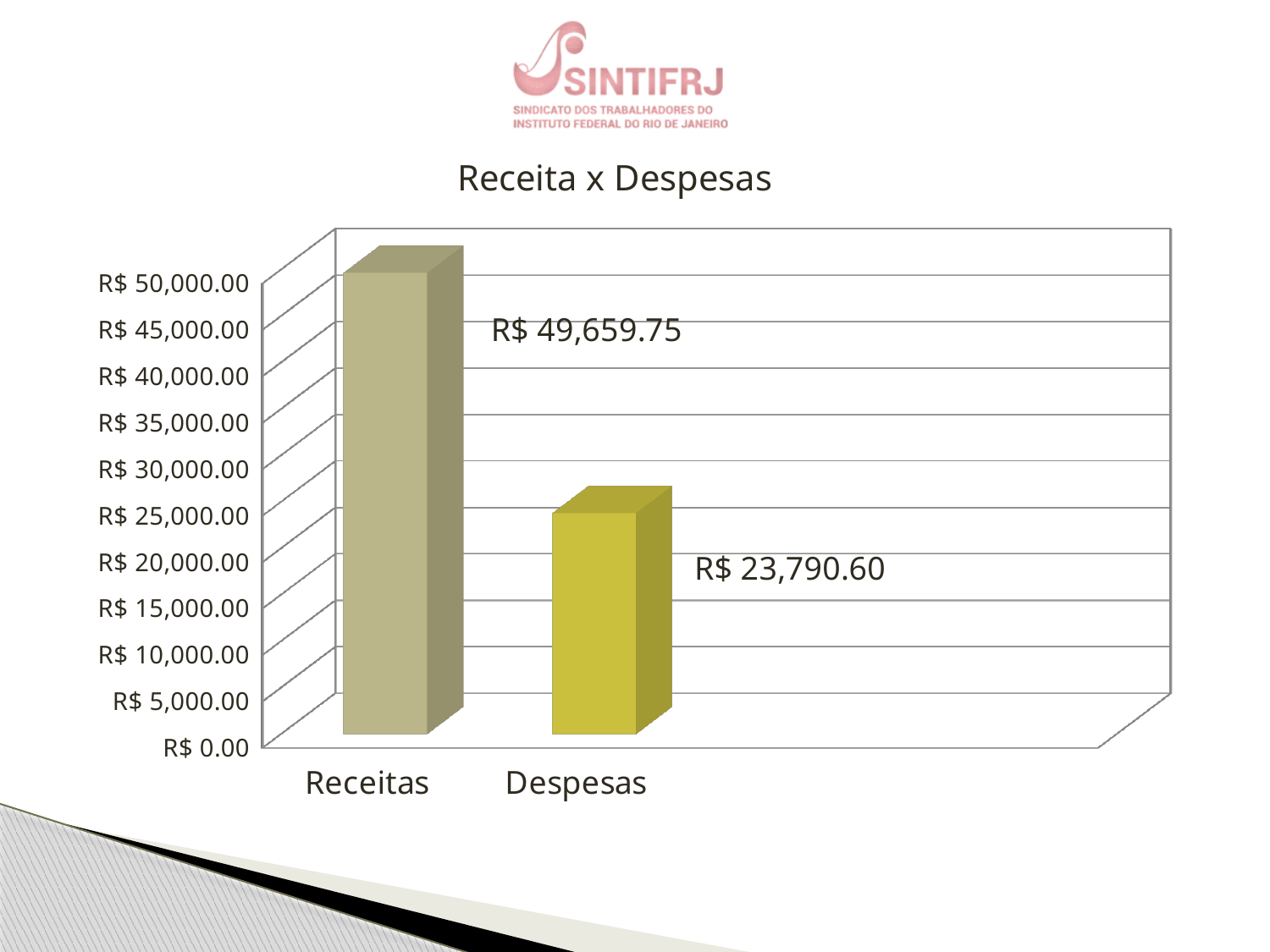
Is the value for Receitas greater or less than R$ 45,000.00? greater Which is larger, the value for Receitas or the value for Despesas? Receitas Which category has the highest value? Receitas What kind of chart is shown on the slide? bar chart How many categories are shown on the chart? 2 What is the highest value labelled on the vertical axis? R$ 50,000.00 What is the title of the chart? Receita x Despesas Is the value for Despesas greater or less than R$ 25,000.00? less What is the difference between the values for Receitas and Despesas? R$ 25,869.15 Which category has the lowest value? Despesas What is the value for Receitas? R$ 49,659.75 What is the value for Despesas? R$ 23,790.60